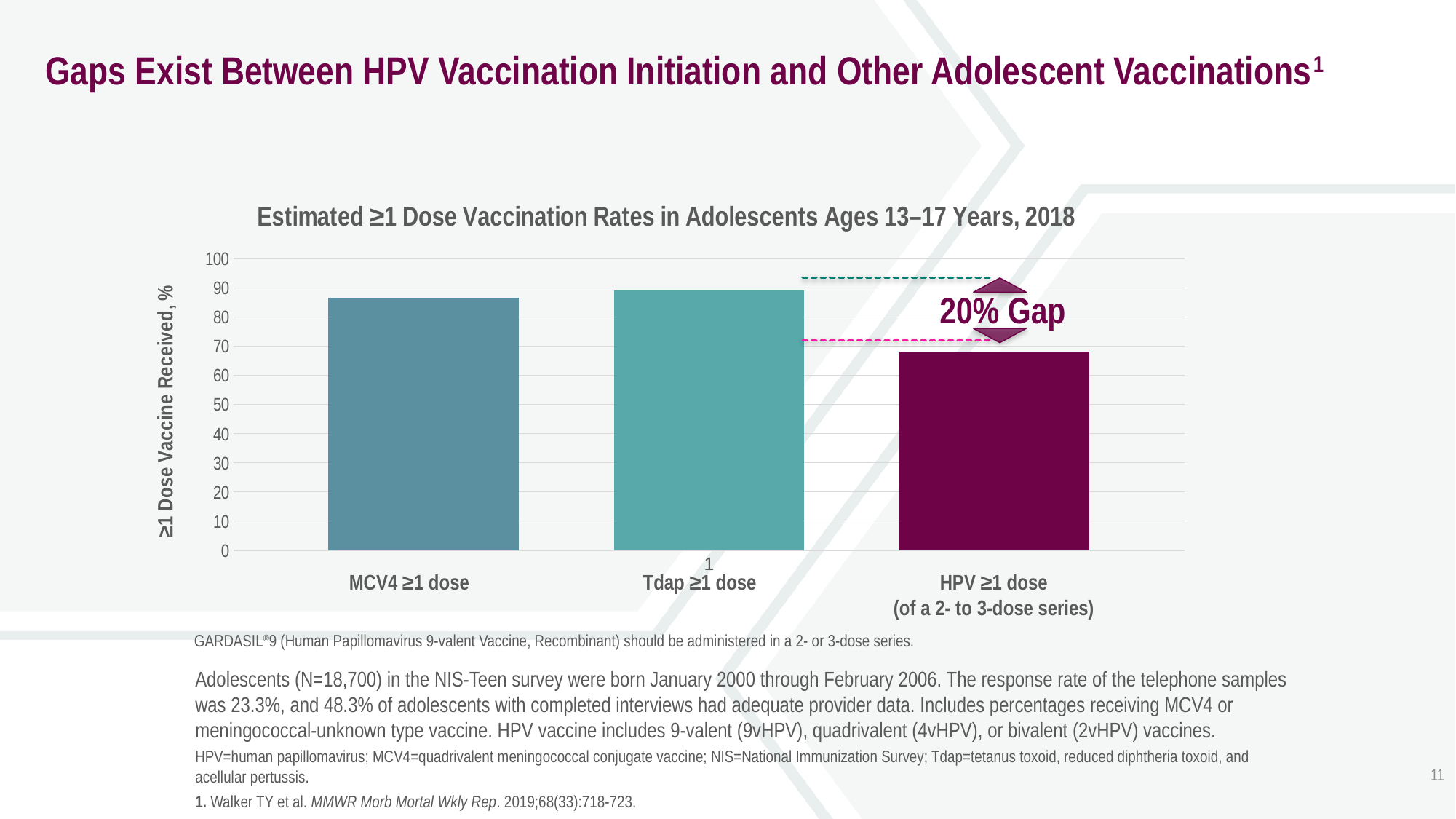
What kind of chart is shown on the slide? bar chart What is the title of the chart? Estimated ≥1 Dose Vaccination Rates in Adolescents Ages 13–17 Years, 2018 Is the value for MCV4 ≥1 dose greater or less than 80? greater Is the value for HPV ≥1 dose greater or less than 70? less Which is larger, the value for Tdap ≥1 dose or the value for HPV ≥1 dose? Tdap ≥1 dose Is the value for HPV ≥1 dose greater or less than 60? greater Which vaccine category has the lowest ≥1 dose vaccination rate? HPV ≥1 dose How many vaccine categories are plotted in the chart? 3 What gap between HPV and the other vaccinations is annotated on the chart? 20% Gap Which is larger, the value for MCV4 ≥1 dose or the value for HPV ≥1 dose? MCV4 ≥1 dose